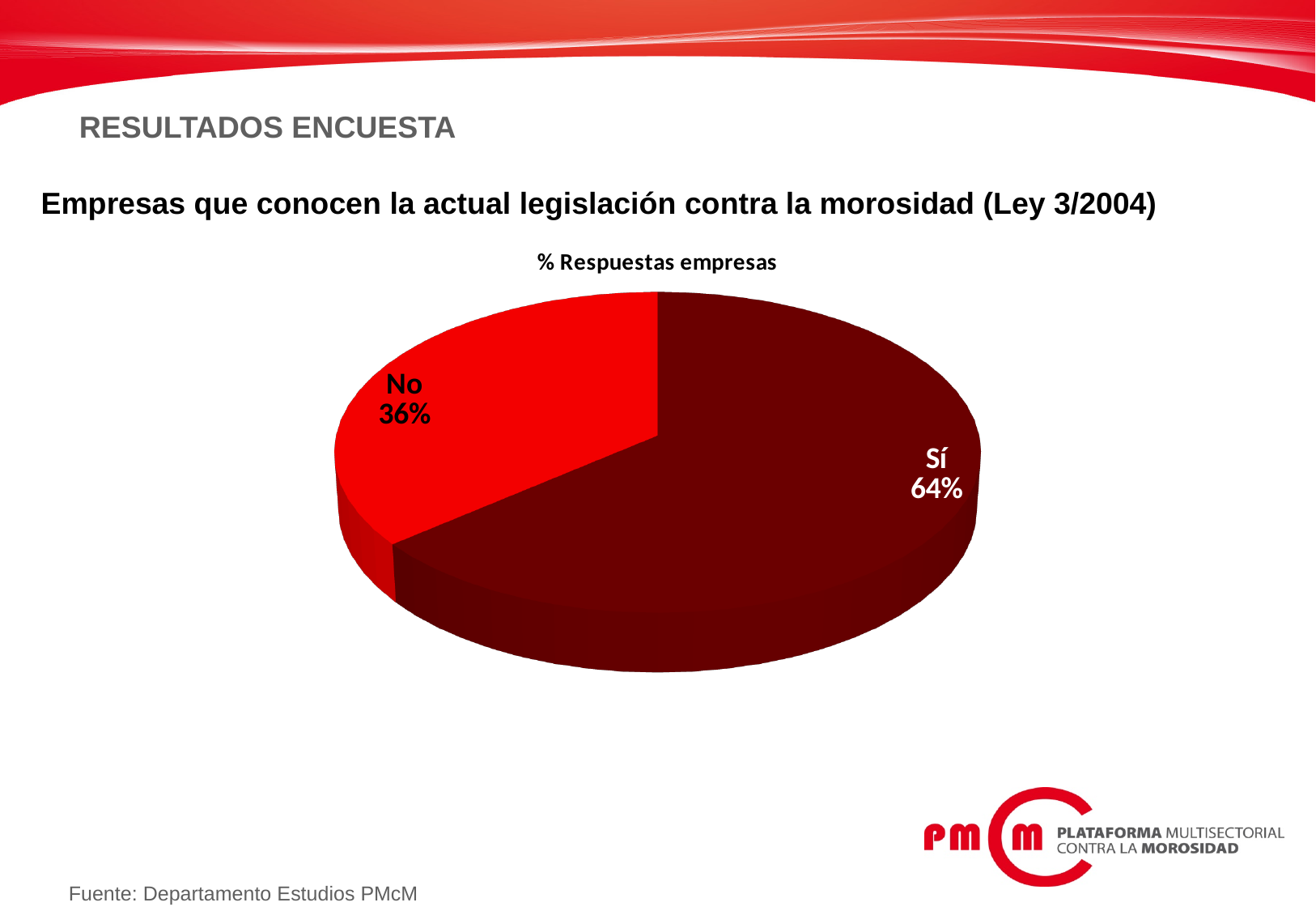
What colour is the "No" slice? bright red Which response has the smallest share of the pie? No How many slices does the pie chart have? 2 What is the difference in percentage points between the "Sí" and "No" slices? 28 What percentage of companies answered "Sí"? 64% What is the title of the chart? % Respuestas empresas What percentage of companies answered "No"? 36% What share of the pie does the "Sí" slice represent? 64% Which slice is larger, "Sí" or "No"? Sí What kind of chart is shown on the slide? pie chart Which response has the largest share of the pie? Sí